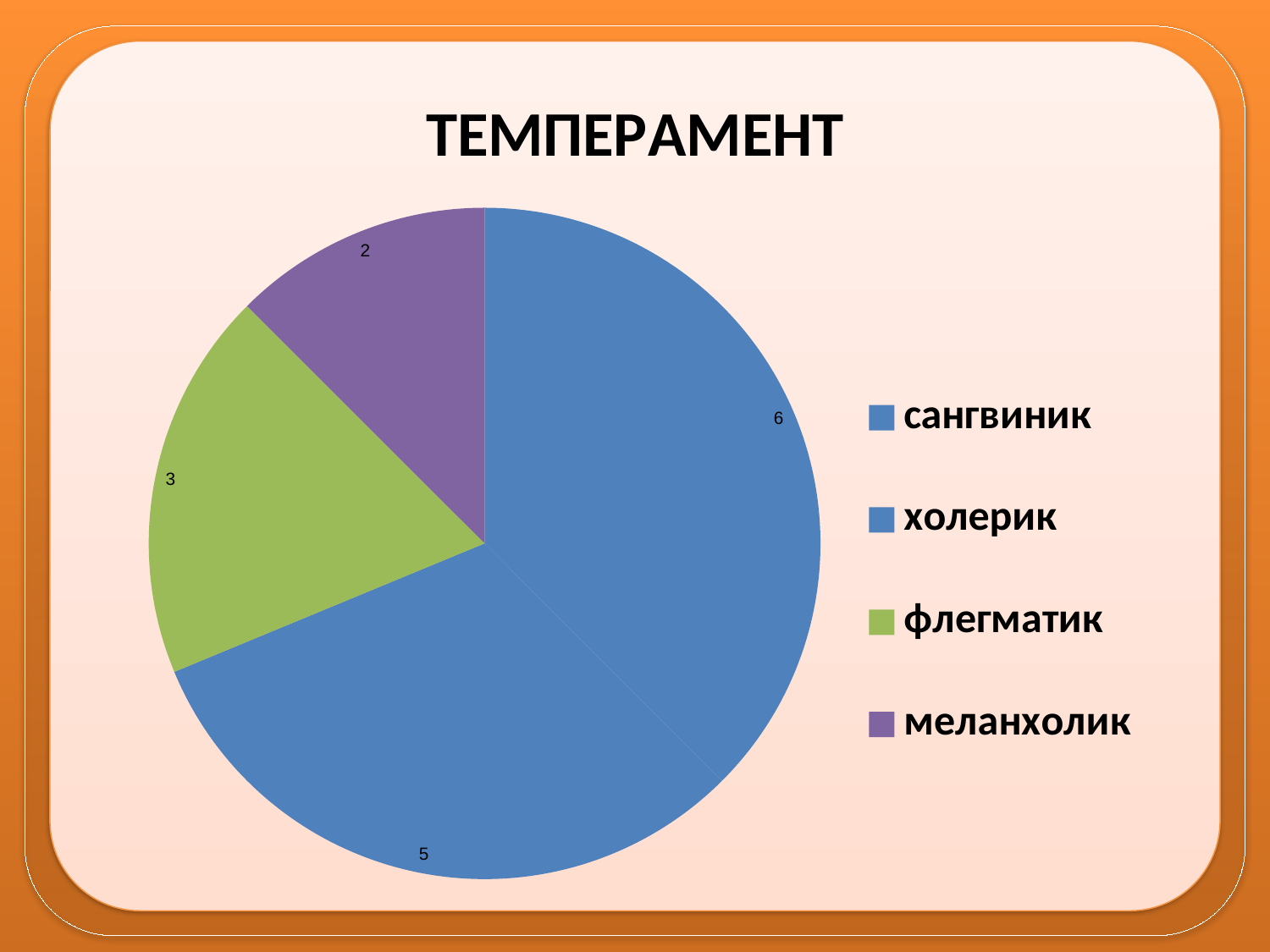
What kind of chart is shown on the slide? pie chart Which category has the smallest slice? меланхолик What is the value for флегматик? 3 How many slices does the pie chart have? 4 How many entries does the legend list? 4 What share of the pie does меланхолик represent? 12.5% What is the value for сангвиник? 6 What is the difference between the values for флегматик and меланхолик? 1 What is the title of the chart? ТЕМПЕРАМЕНТ What is the value for холерик? 5 Which category has the largest slice? сангвиник What is the value for меланхолик? 2